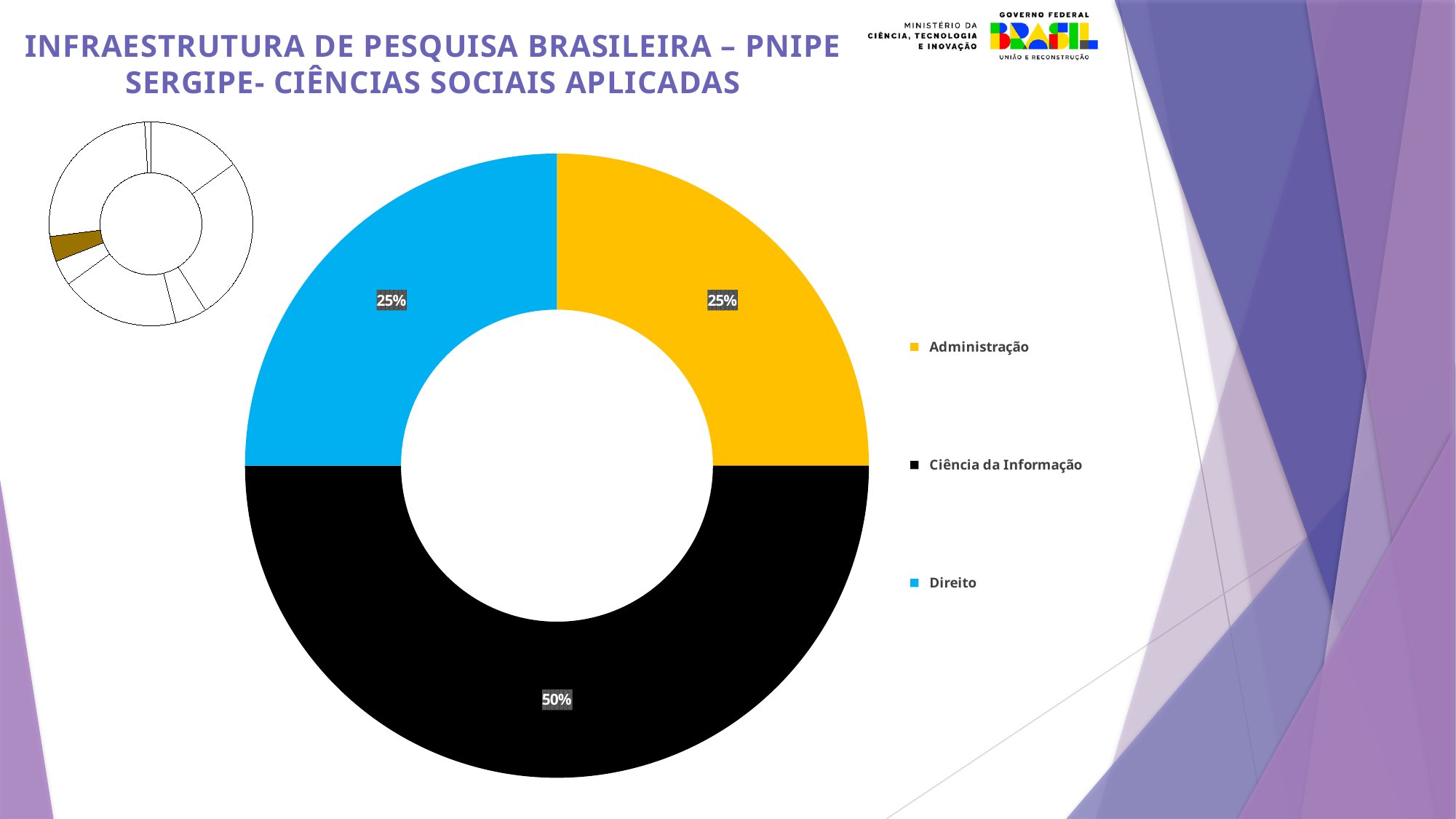
What kind of chart is the large chart in the centre of the slide? Doughnut (pie) chart In the large doughnut chart, what colour is the Administração slice? Yellow In the large doughnut chart, what share of the whole does the Direito slice represent? 25% In the large doughnut chart, what share is shown for Ciência da Informação? 50% In the large doughnut chart, what is the difference between the share for Ciência da Informação and the share for Administração? 25% How many entries does the legend of the large doughnut chart list? 3 In the large doughnut chart, what share is shown for Direito? 25% In the large doughnut chart, which category has the largest share? Ciência da Informação In the large doughnut chart, which category is shown in black? Ciência da Informação How many categories are shown in the large doughnut chart? 3 In the large doughnut chart, what share is shown for Administração? 25% In the large doughnut chart, which is larger: the share for Ciência da Informação or the share for Direito? Ciência da Informação